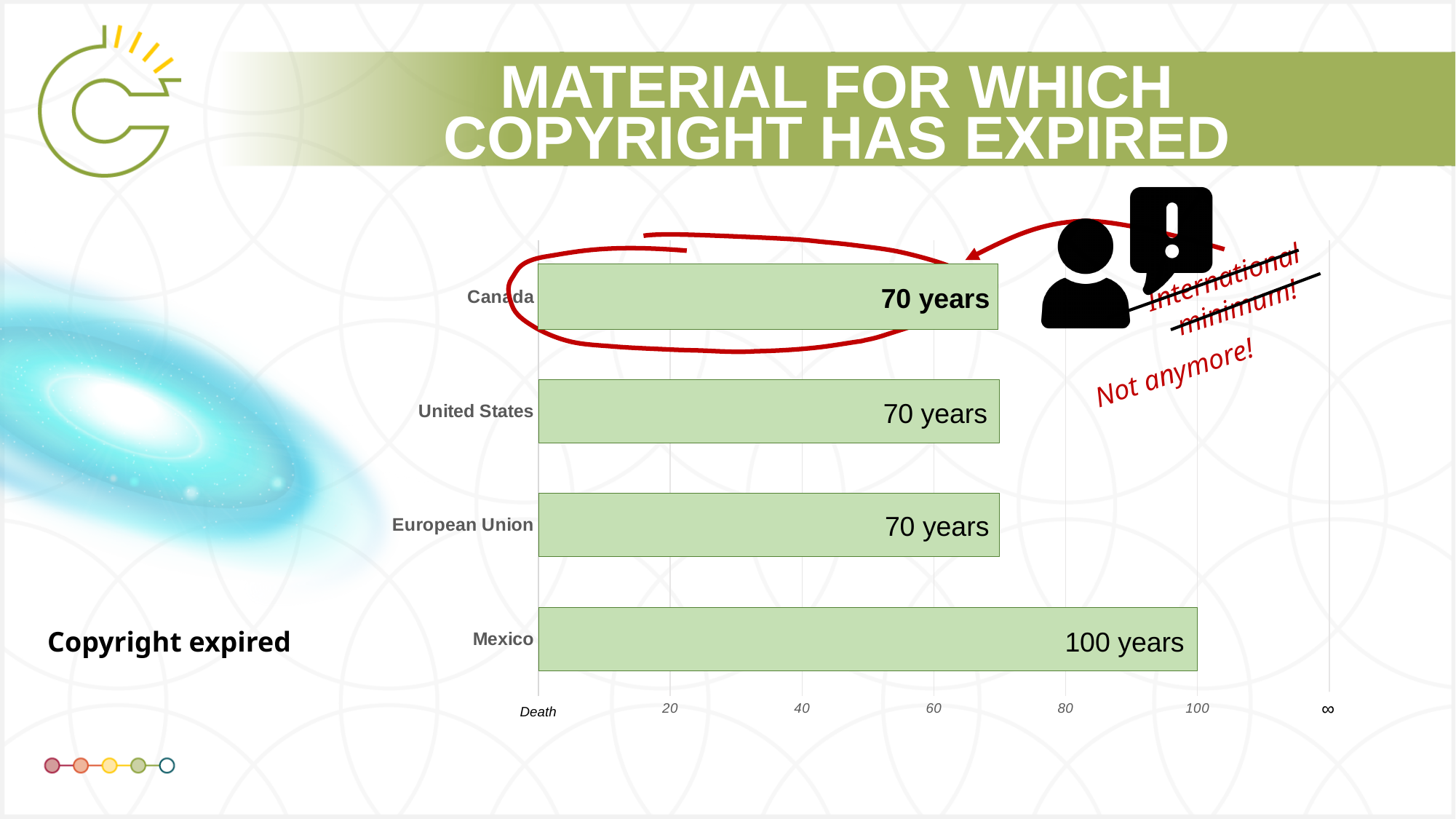
How many countries or regions are shown on the chart? 4 Which country or region has the longest copyright term on the chart? Mexico What kind of chart is shown on the slide? Bar chart Is the value for Mexico greater or less than 80? greater What is the copyright term shown for the United States? 70 years How many years longer is Mexico's copyright term than Canada's? 30 years What is the copyright term shown for the European Union? 70 years What is the copyright term shown for Canada? 70 years Which bar on the chart is circled in red? Canada What label appears at the left end of the horizontal axis? Death Which has a longer copyright term, Mexico or the United States? Mexico What is the copyright term shown for Mexico? 100 years